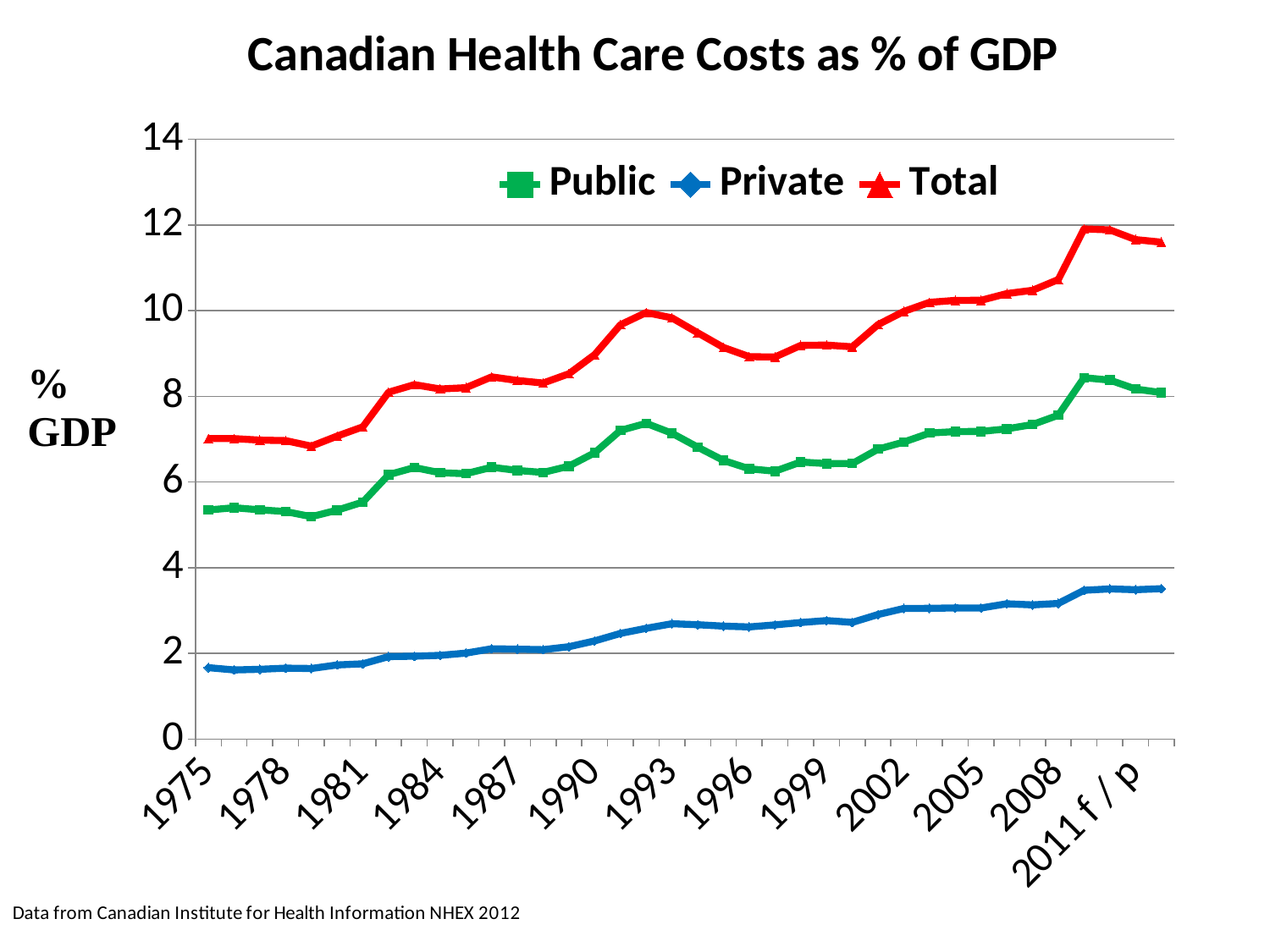
What is the title of the chart? Canadian Health Care Costs as % of GDP Which series has the lowest values throughout the chart? Private Is the value for Total at the last point (2011 f / p) greater or less than 10? greater Is the value for Private in 1975 greater or less than 2? less Does the Private series generally rise or fall from 1975 to 2011? Rise Which series is plotted in red? Total Which is larger in 1975, the Public value or the Private value? Public Is the value for Total in 1975 greater or less than 6? greater Which series has the highest values throughout the chart? Total What kind of chart is shown on the slide? Line chart How many series does the legend list? 3